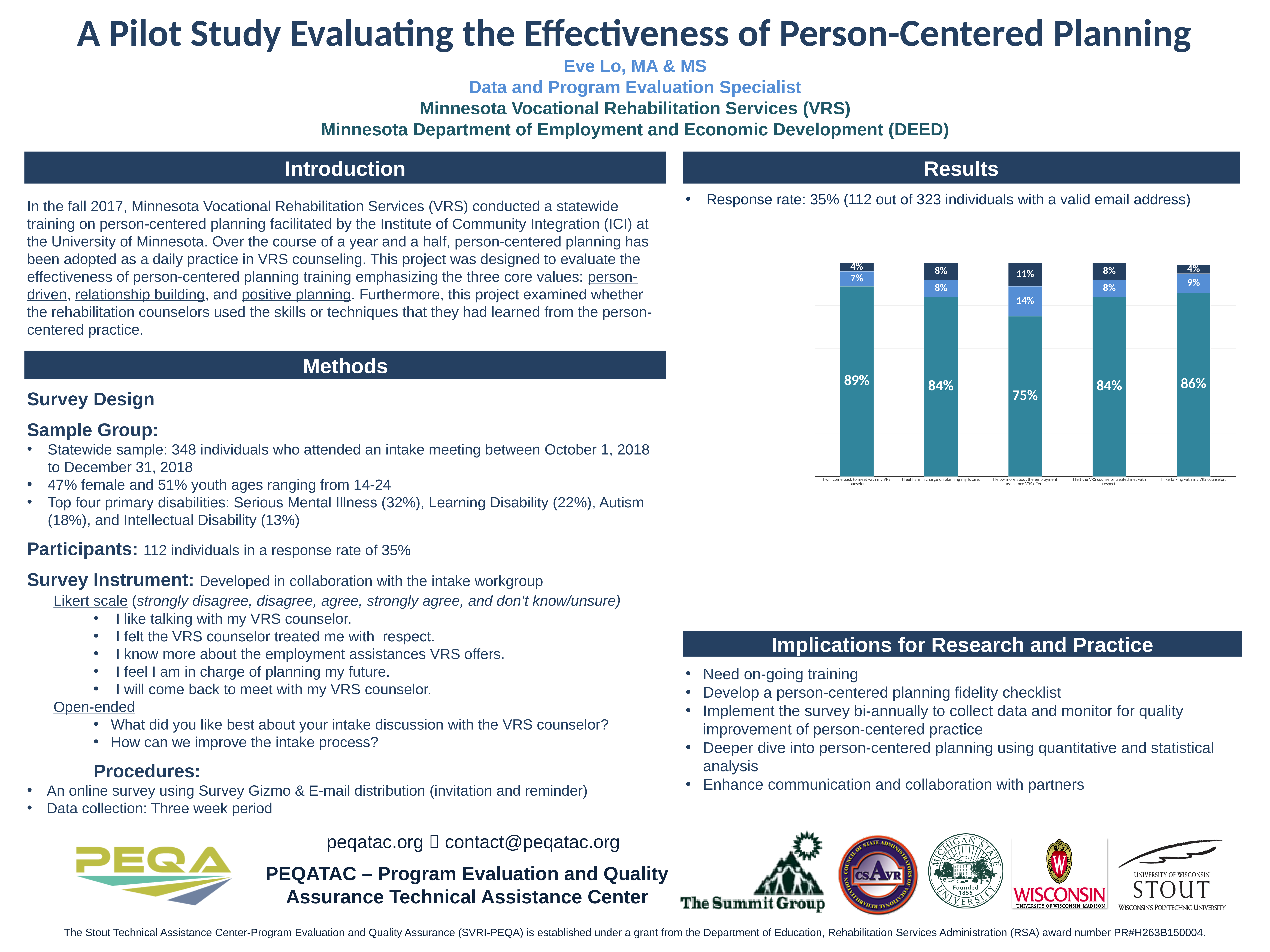
In the Results chart, what is the value of the bottom (teal) segment for "I know more about the employment assistance VRS offers"? 75% In the Results chart, is the bottom (teal) segment larger for "I like talking with my VRS counselor" or for "I feel I am in charge on planning my future"? I like talking with my VRS counselor. In the Results chart, what is the value of the middle (light blue) segment for "I like talking with my VRS counselor"? 9% In the Results chart, which survey statement has the largest bottom (teal) segment? I will come back to meet with my VRS counselor. In the Results chart, what is the value of the top (dark navy) segment for "I know more about the employment assistance VRS offers"? 11% In the Results chart, what is the value of the middle (light blue) segment for "I felt the VRS counselor treated me with respect"? 8% In the Results chart, what is the total of the three labelled segments for "I know more about the employment assistance VRS offers"? 100% In the Results chart, which survey statement has the smallest bottom (teal) segment? I know more about the employment assistance VRS offers. How many categories (survey statements) are plotted in the Results chart? 5 What kind of chart is shown in the Results section? stacked bar chart In the Results chart, what is the difference between the bottom (teal) segment values for "I will come back to meet with my VRS counselor" and "I know more about the employment assistance VRS offers"? 14% In the Results chart, what is the value of the bottom (teal) segment for "I will come back to meet with my VRS counselor"? 89%